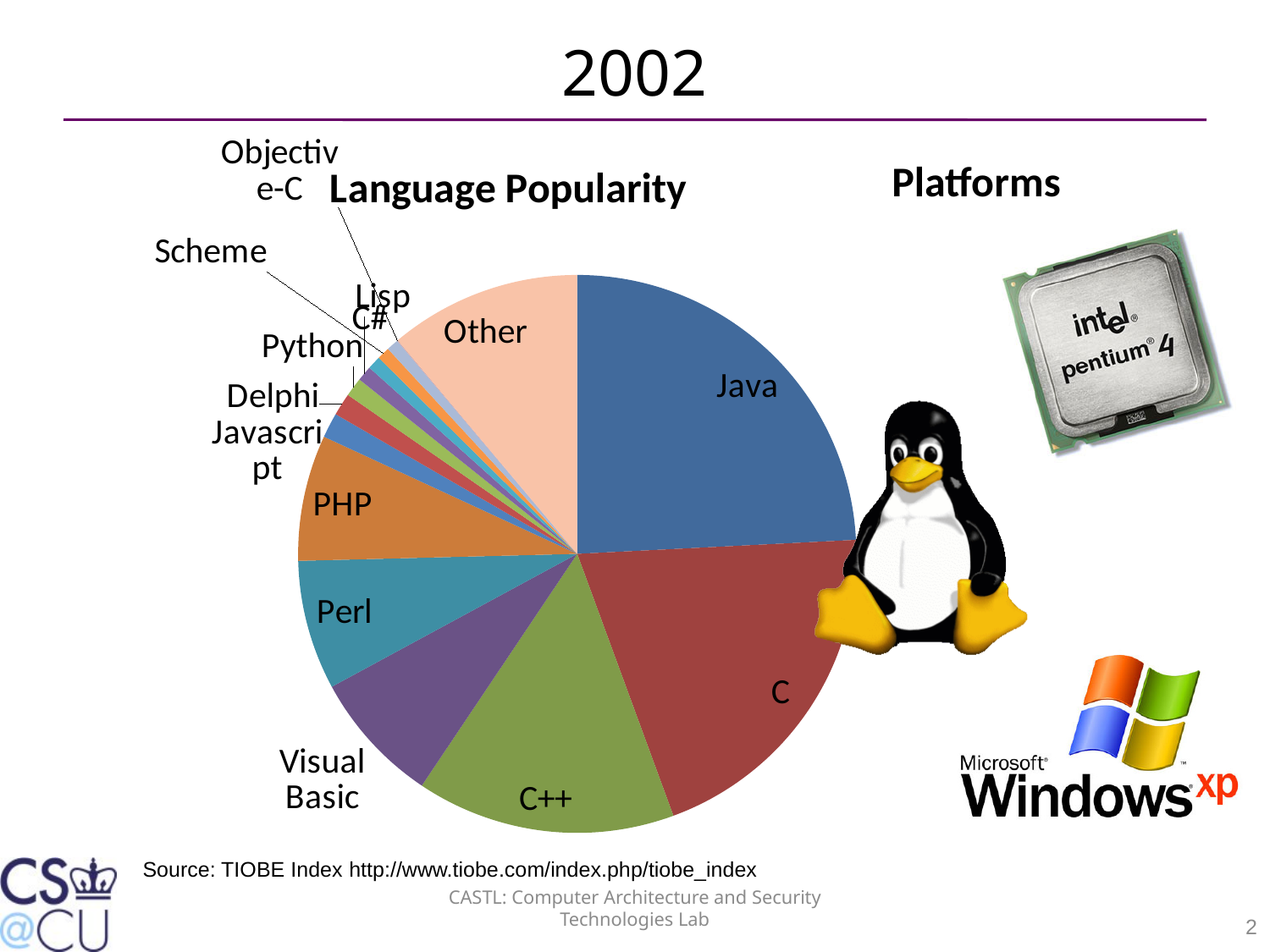
In the Language Popularity pie chart, which slice is larger, Java or Perl? Java In the Language Popularity pie chart, which slice is larger, C or PHP? C In the Language Popularity pie chart, which slice is larger, Java or C++? Java What kind of chart is the Language Popularity chart? pie chart What is the title of the pie chart on the slide? Language Popularity Which language has the largest slice in the Language Popularity pie chart? Java Which slice of the Language Popularity pie chart is coloured blue and sits at the top right? Java